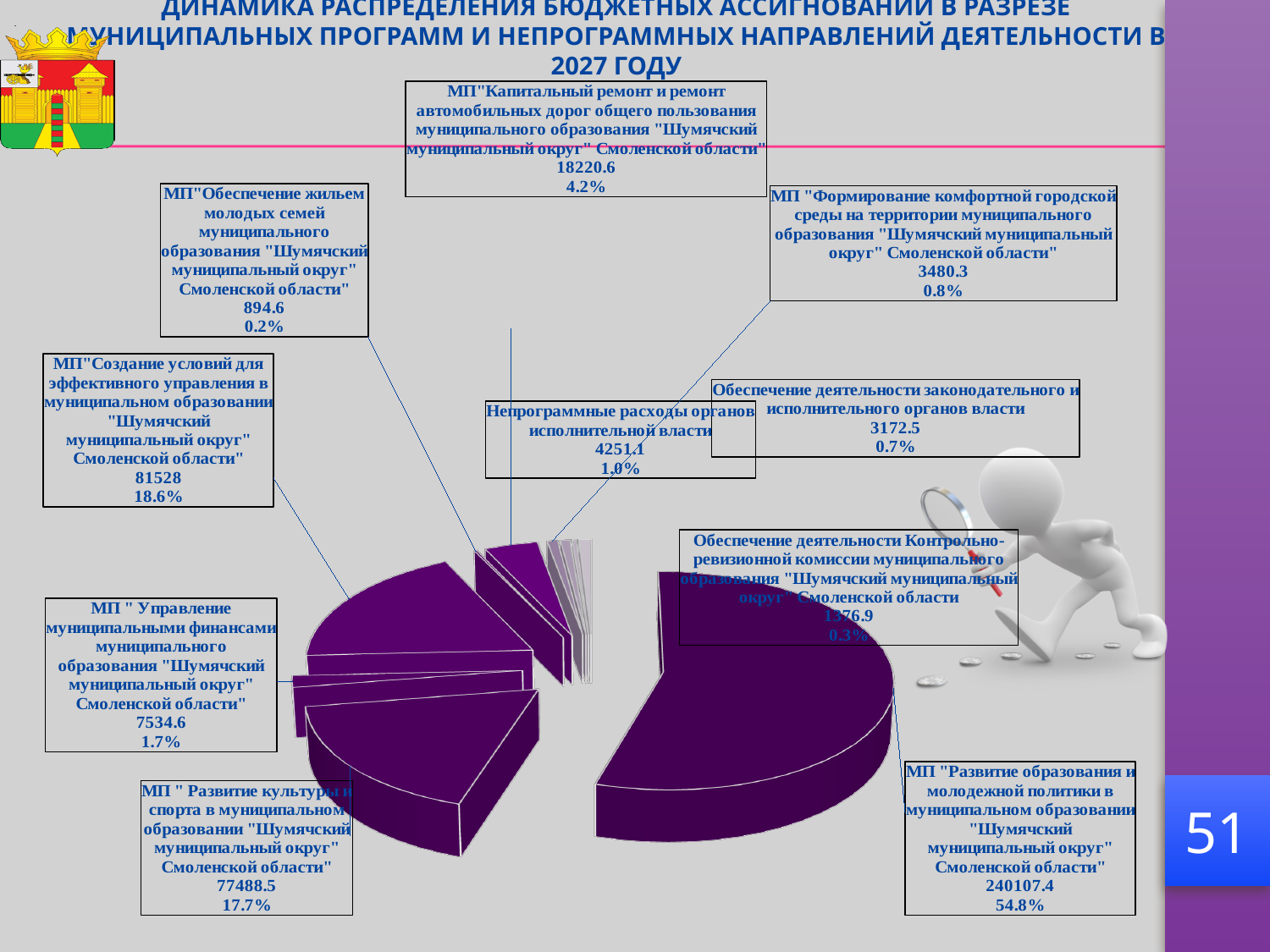
What is the value for МП "Создание условий для эффективного управления в муниципальном образовании"? 81528 What is the difference between the values for МП "Создание условий для эффективного управления" (81528) and МП "Развитие культуры и спорта" (77488.5)? 4039.5 Which is larger: the value for МП "Капитальный ремонт и ремонт автомобильных дорог" or for МП "Управление муниципальными финансами"? МП "Капитальный ремонт и ремонт автомобильных дорог" How many categories (slices) does the pie chart have? 10 Which category has the largest share of the pie? МП "Развитие образования и молодежной политики" What is the value for МП "Развитие образования и молодежной политики"? 240107.4 What is the value for Непрограммные расходы органов исполнительной власти? 4251.1 What share of the pie does МП "Развитие образования и молодежной политики" take? 54.8% What is the share of the pie for Обеспечение деятельности Контрольно-ревизионной комиссии? 0.3% Which category has the smallest share of the pie? МП "Обеспечение жильем молодых семей" What kind of chart is shown on the slide? Pie chart What share of the pie does МП "Развитие культуры и спорта" take? 17.7%